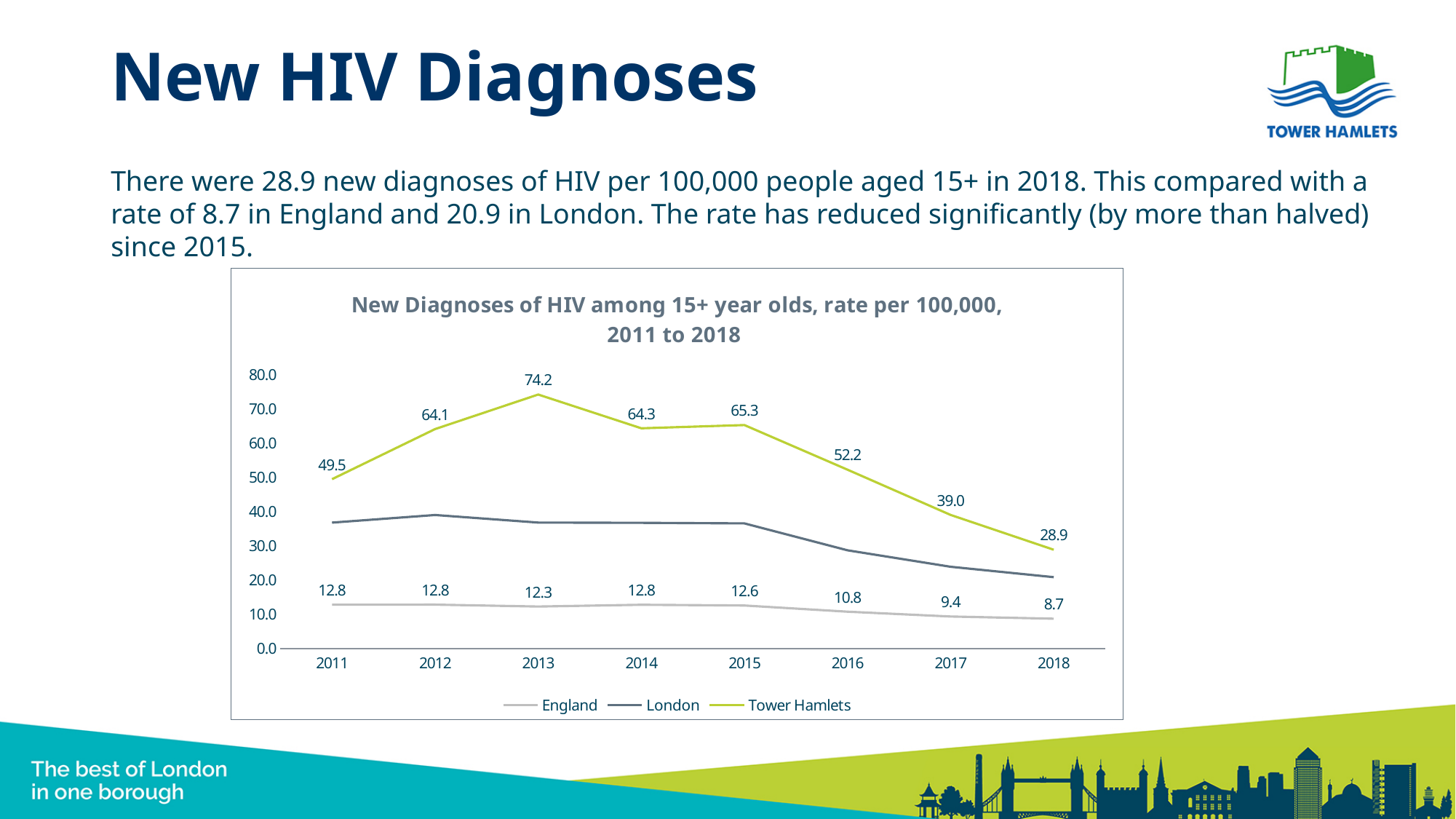
What is the difference between the Tower Hamlets rate in 2015 and in 2018? 36.4 In which year was the Tower Hamlets rate lowest? 2018 Which was higher in 2016, the Tower Hamlets rate or the England rate? Tower Hamlets How many years are shown on the x axis? 8 What was the Tower Hamlets rate of new HIV diagnoses in 2013? 74.2 What type of chart is shown on the slide? line chart Did the Tower Hamlets rate rise or fall between 2015 and 2018? fall In which year was the Tower Hamlets rate highest? 2013 What was the England rate of new HIV diagnoses in 2017? 9.4 Is the London rate in 2012 greater or less than 30.0? greater How many series does the legend list? 3 Which series is drawn in green? Tower Hamlets